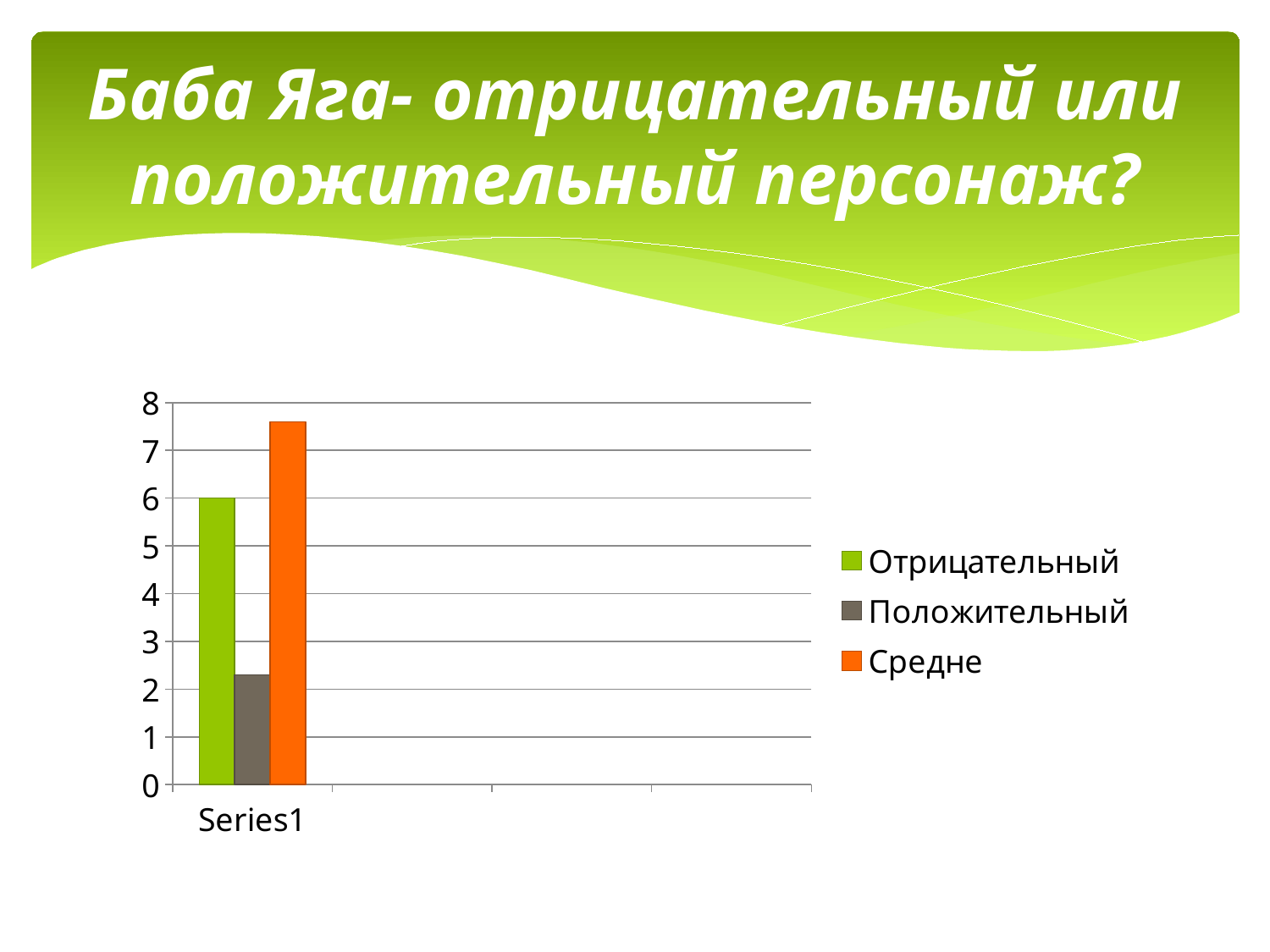
Is the value for Положительный greater or less than 3? less Is the value for Положительный greater or less than 2? greater Which series has the highest bar? Средне How many series does the legend list? 3 Is the value for Средне greater or less than 7? greater What kind of chart is shown on the slide? bar chart Which is larger, the value for Средне or the value for Отрицательный? Средне Which series has the lowest bar? Положительный What colour is the bar for Средне? orange Which is larger, the value for Отрицательный or the value for Положительный? Отрицательный How many categories are labelled on the x axis? 1 What is the value for Отрицательный? 6